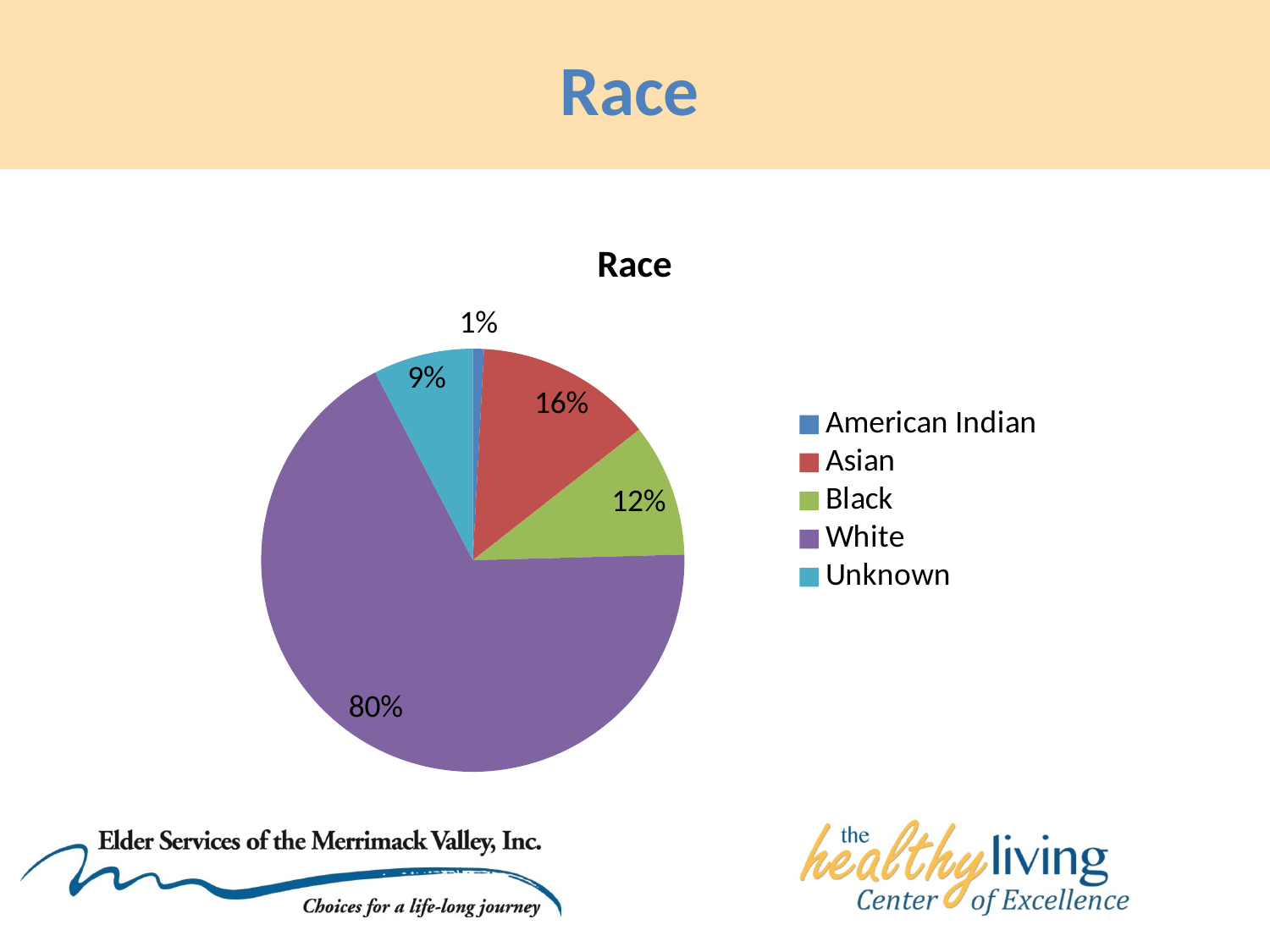
Which is larger, the share for Asian or the share for Black? Asian What percentage of the pie is Asian? 16% What percentage of the pie is Black? 12% What percentage of the pie is White? 80% Which category has the largest share of the pie? White How many categories does the legend list? 5 What percentage of the pie is Unknown? 9% Which category has the smallest share of the pie? American Indian What kind of chart is shown on the slide? pie chart What is the title of the chart? Race What is the difference in percentage points between the White share and the Asian share? 64 What percentage of the pie is American Indian? 1%